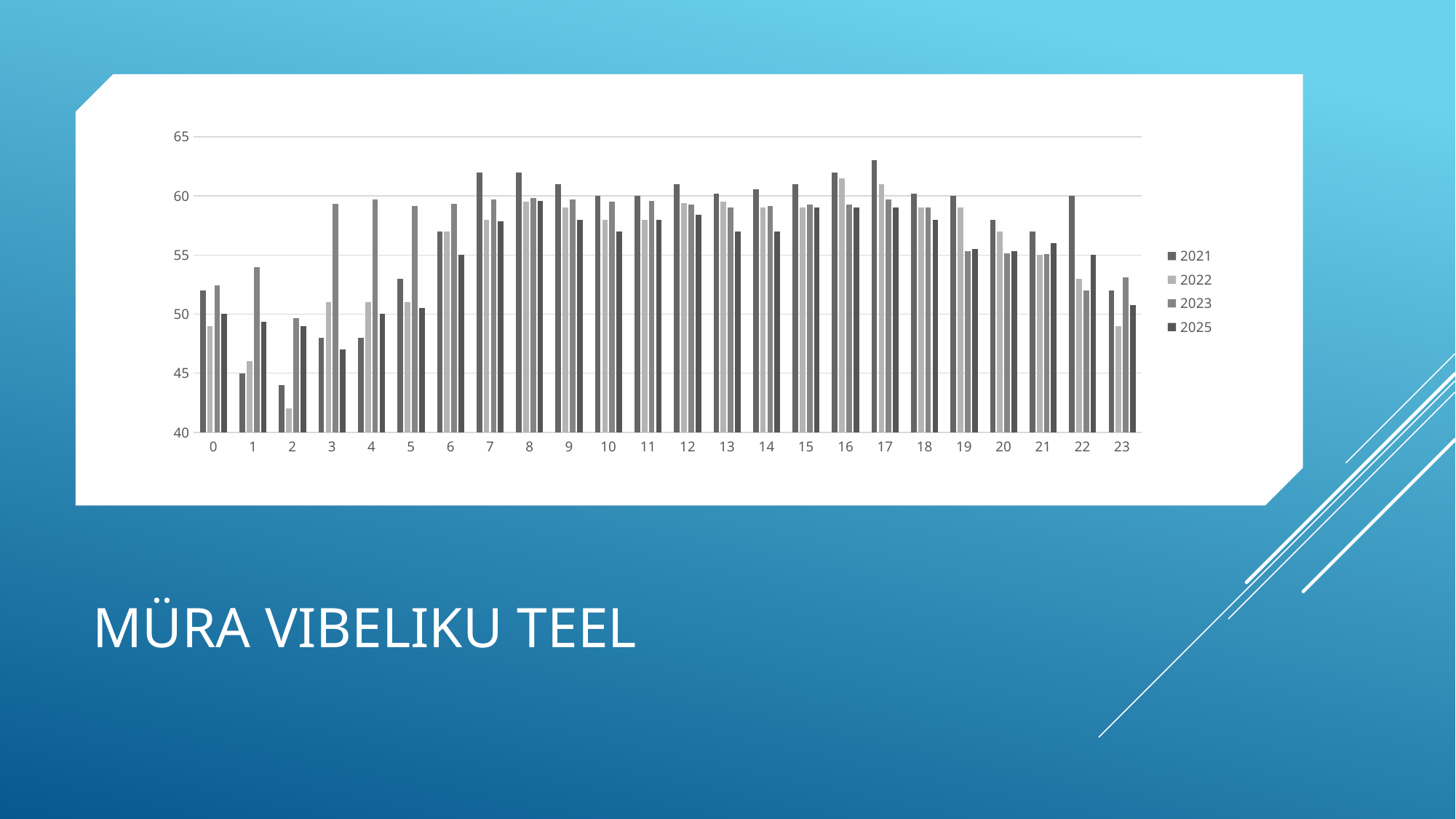
Is the value for 2022 at category 2 greater or less than 45? less What kind of chart is shown on the slide? bar chart Is the value for 2021 at category 1 greater or less than 50? less Is the value for 2021 at category 17 greater or less than 60? greater At category 17, which series has the highest bar? 2021 How many categories are shown along the x axis? 24 At category 3, which is larger: the value for 2021 or the value for 2023? 2023 For the 2022 series, which category has the lowest bar? 2 For the 2021 series, do the values rise or fall from category 0 to category 7? rise Which years are listed in the legend? 2021, 2022, 2023, 2025 How many series does the legend list? 4